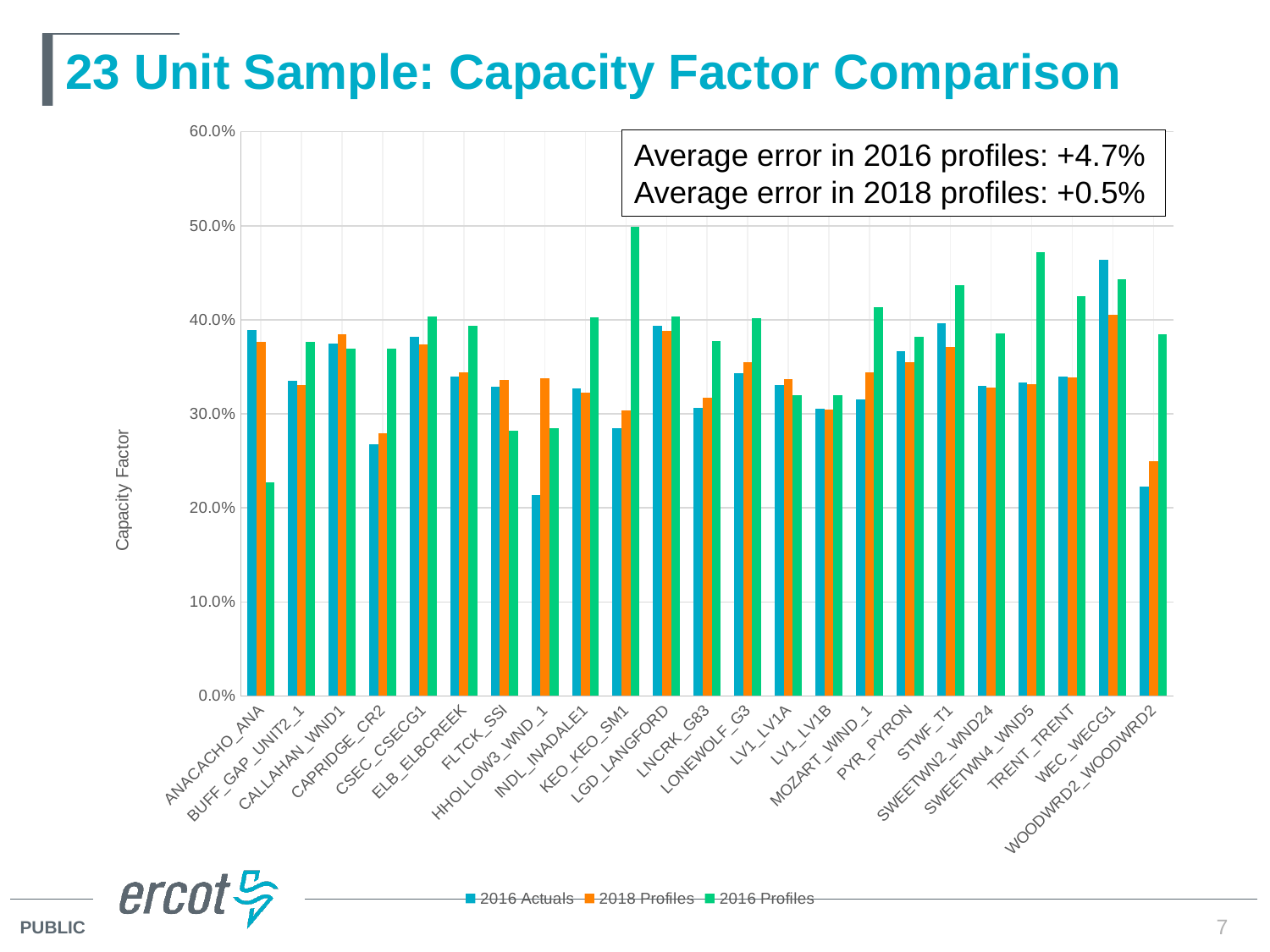
For ANACACHO_ANA, which is larger: the 2016 Actuals value or the 2016 Profiles value? 2016 Actuals Is the 2016 Actuals value for WEC_WECG1 greater or less than 40.0%? greater How many units (categories) are plotted along the x axis? 23 Is the 2018 Profiles value for WOODWRD2_WOODWRD2 greater or less than 30.0%? less Which unit has the highest 2016 Actuals value? WEC_WECG1 For KEO_KEO_SM1, which is larger: the 2016 Profiles value or the 2016 Actuals value? 2016 Profiles Which unit has the lowest 2016 Actuals value? HHOLLOW3_WND_1 According to the text box on the chart, what is the average error in 2018 profiles? +0.5% Which unit has the lowest 2016 Profiles value? ANACACHO_ANA Which unit has the highest 2016 Profiles value? KEO_KEO_SM1 How many series does the legend list? 3 What kind of chart is shown on the slide? bar chart